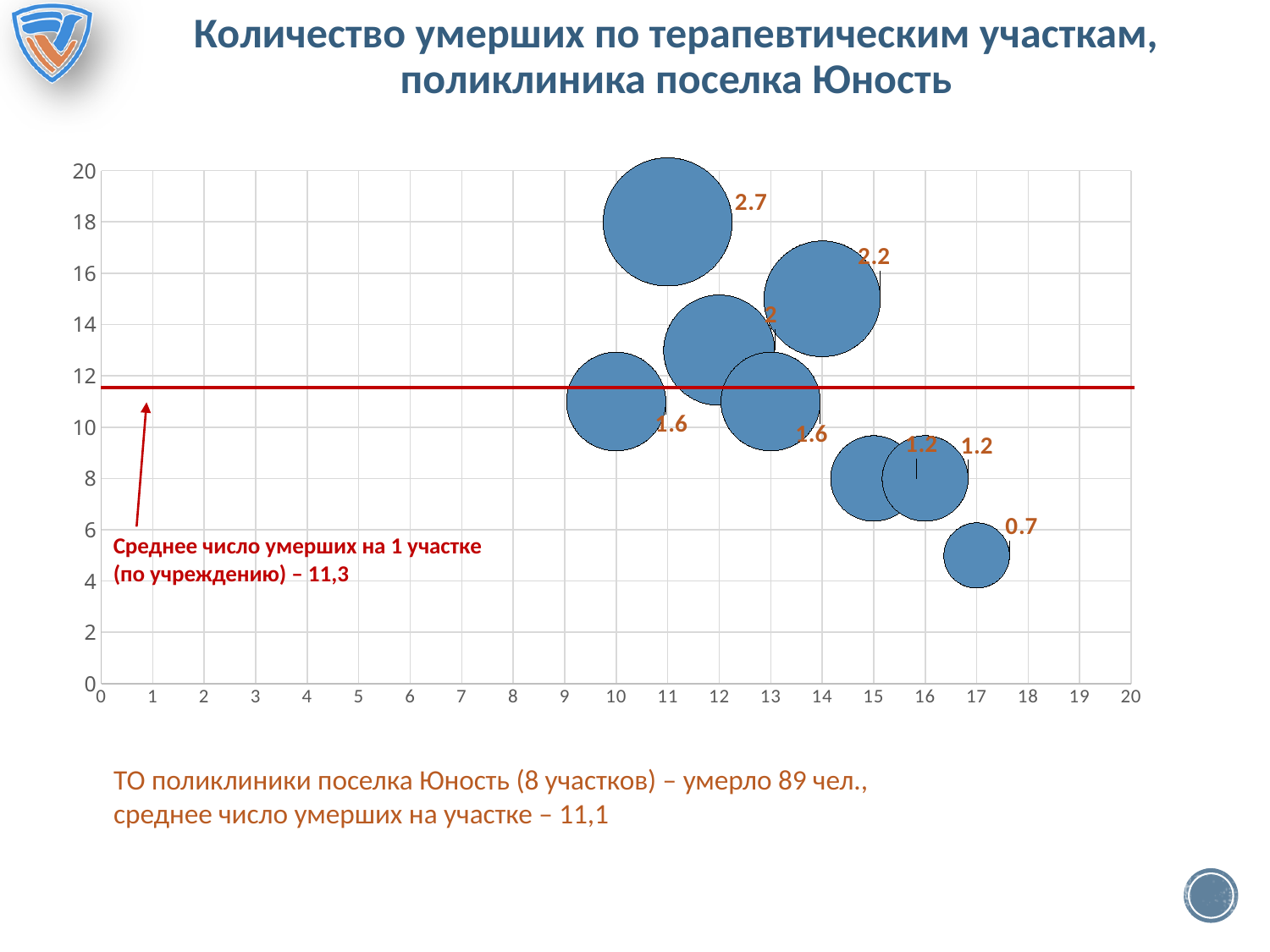
What is the smallest data label shown on any bubble in the chart? 0.7 Which bubble label is larger, 2.2 or 1.6? 2.2 What kind of chart is shown on the slide? bubble chart What value does the horizontal red line on the chart represent, according to the annotation? 11,3 How many bubbles are plotted on the chart? 8 What is the largest data label shown on any bubble in the chart? 2.7 Is the y-axis value of the bubble labelled 2.7 greater or less than 16? greater Is the y-axis value of the bubble labelled 0.7 greater or less than 6? less How many bubbles carry the label 1.6? 2 What is the title of the chart? Количество умерших по терапевтическим участкам, поликлиника поселка Юность What is the difference between the largest bubble label (2.7) and the smallest bubble label (0.7)? 2 Is the y-axis value of the bubble labelled 2.2 greater or less than 14? greater